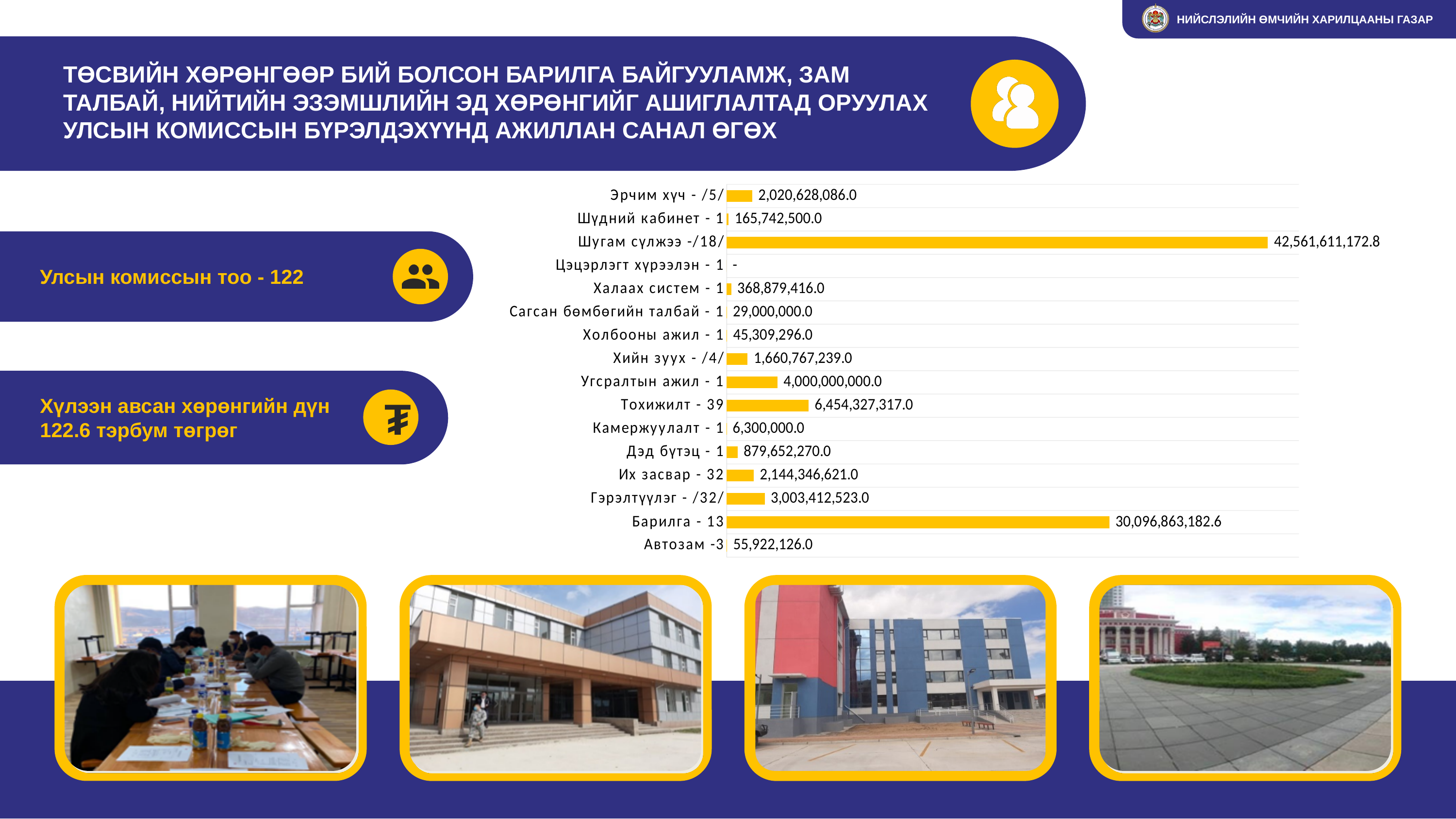
What is the difference between the values for Их засвар - 32 and Эрчим хүч - /5/? 123,718,535.0 Which category has the highest value in the bar chart? Шугам сүлжээ -/18/ What value is shown for Шугам сүлжээ -/18/ in the bar chart? 42,561,611,172.8 What is the difference between the values for Угсралтын ажил - 1 and Хийн зуух - /4/? 2,339,232,761.0 Among the categories with a numeric value printed, which has the lowest value? Камержуулалт - 1 What value is shown for Тохижилт - 39 in the bar chart? 6,454,327,317.0 Which is larger, the value for Гэрэлтүүлэг - /32/ or the value for Их засвар - 32? Гэрэлтүүлэг - /32/ How many categories are shown in the bar chart? 16 What value is shown for Барилга - 13 in the bar chart? 30,096,863,182.6 What value is shown for Автозам -3 in the bar chart? 55,922,126.0 Which is larger, the value for Барилга - 13 or the value for Тохижилт - 39? Барилга - 13 What kind of chart is shown on the slide? Bar chart